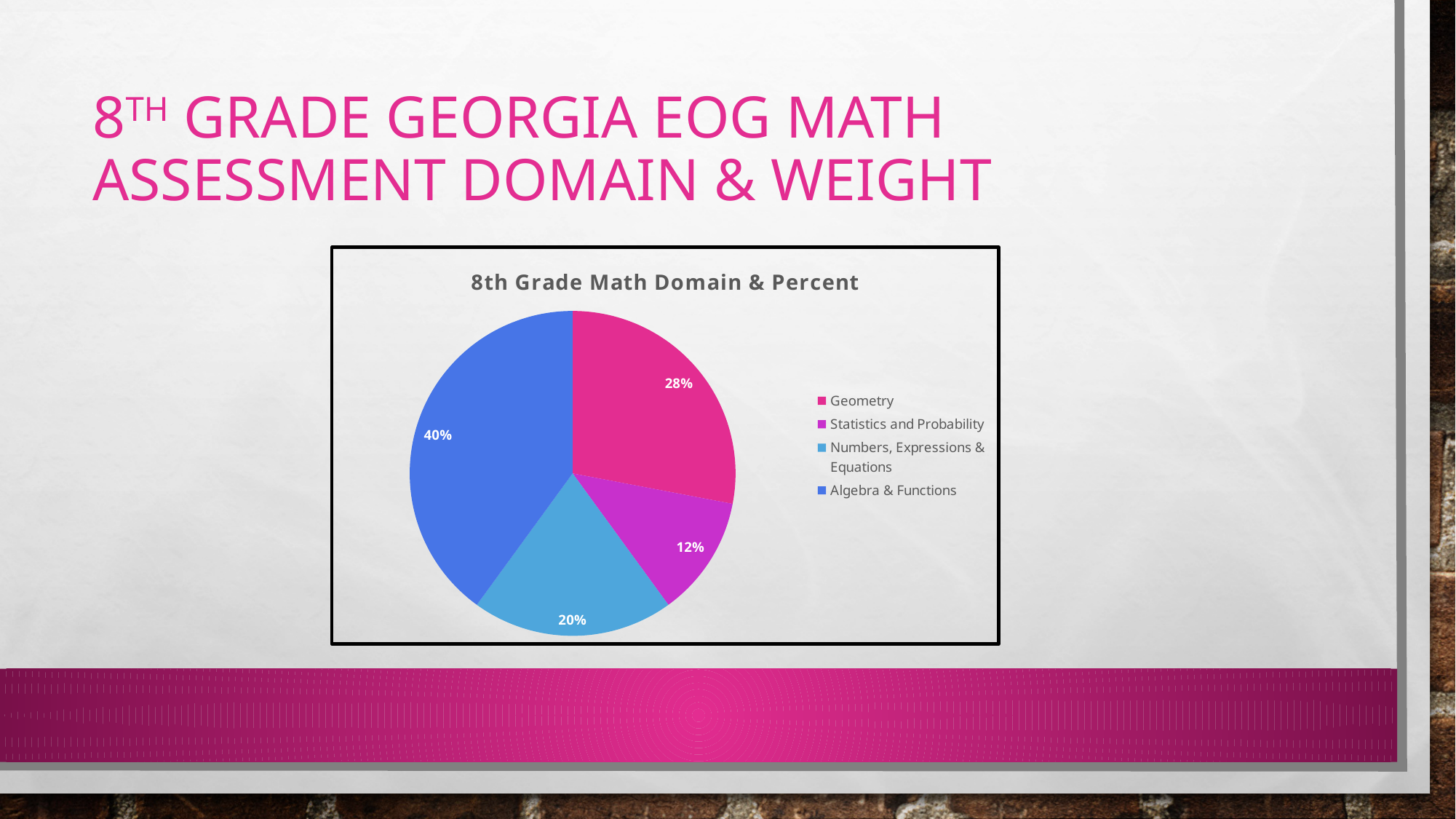
What type of chart is shown on the slide? pie chart How many entries does the legend list? 4 What percentage does the Numbers, Expressions & Equations slice show? 20% What is the difference in percentage points between Algebra & Functions and Geometry? 12 What percentage does the Algebra & Functions slice show? 40% What is the title of the chart? 8th Grade Math Domain & Percent What percentage does the Statistics and Probability slice show? 12% Which domain has the largest share of the pie? Algebra & Functions What percentage does the Geometry slice show? 28% Which domain has the smallest share of the pie? Statistics and Probability Which has a larger share, Geometry or Numbers, Expressions & Equations? Geometry How many slices does the pie chart have? 4